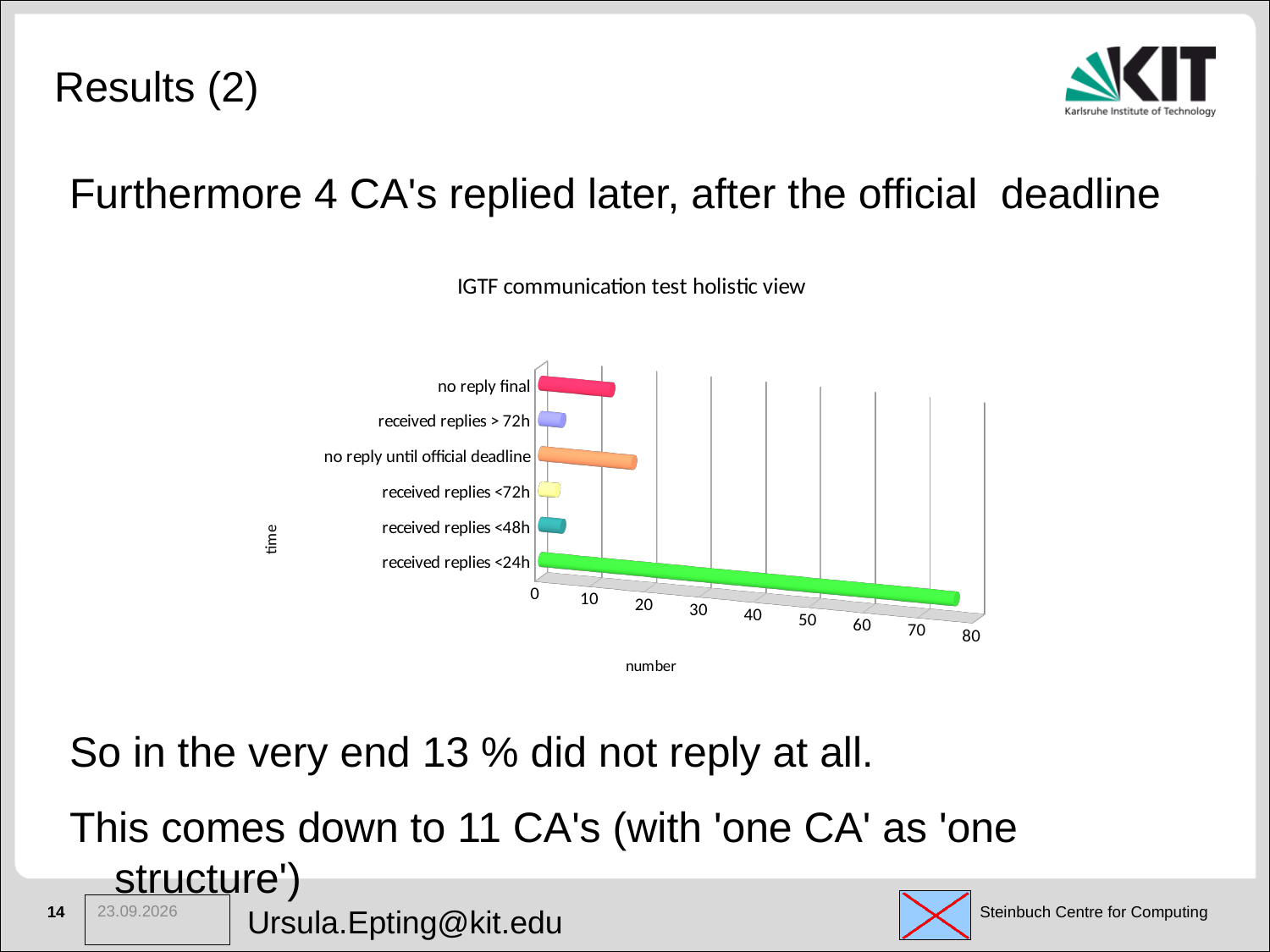
Which is larger: the value for 'received replies <24h' or the value for 'no reply final'? received replies <24h Which is larger: the value for 'no reply until official deadline' or the value for 'received replies <48h'? no reply until official deadline What kind of chart is shown on the slide? bar chart What is the label of the horizontal axis of the chart? number Is the value for 'no reply final' greater or less than 30? less Which category has the highest value in the chart? received replies <24h Is the value for 'received replies > 72h' greater or less than 10? less How many categories are plotted in the chart? 6 Is the value for 'received replies <24h' greater or less than 60? greater What is the title of the chart? IGTF communication test holistic view